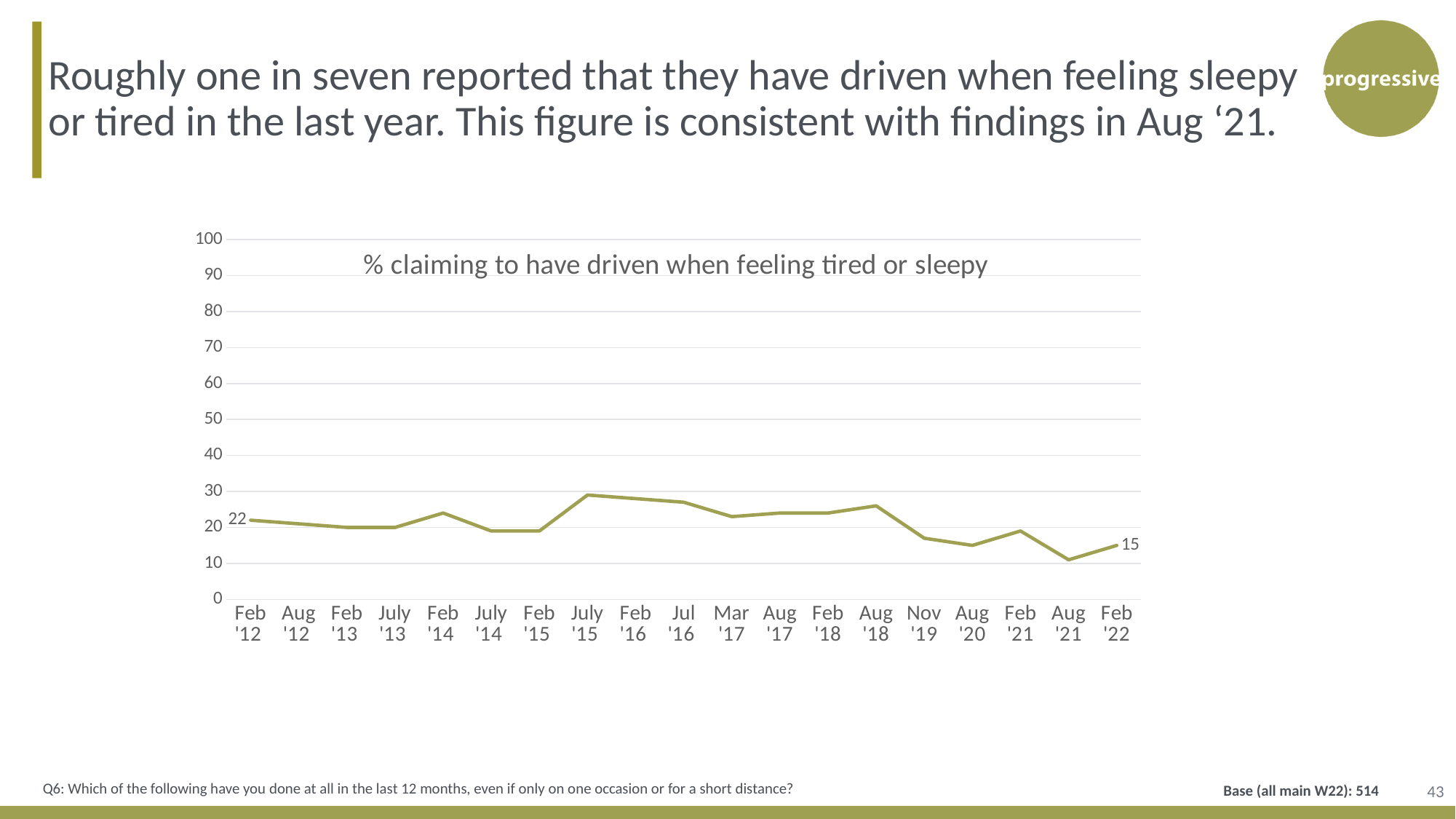
What is the value for Feb '12? 22 How many time points are plotted on the chart? 19 What is the difference between the values for Feb '12 and Feb '22? 7 Is the value for July '15 greater or less than 20? greater Is the value for Aug '21 greater or less than 20? less What type of chart is shown on the slide? line chart What is the value for Feb '22? 15 At which time point is the value lowest? Aug '21 What is the title of the chart? % claiming to have driven when feeling tired or sleepy Which is larger, the value for Feb '12 or the value for Feb '22? Feb '12 At which time point is the value highest? July '15 Does the value rise or fall overall from Feb '12 to Feb '22? fall